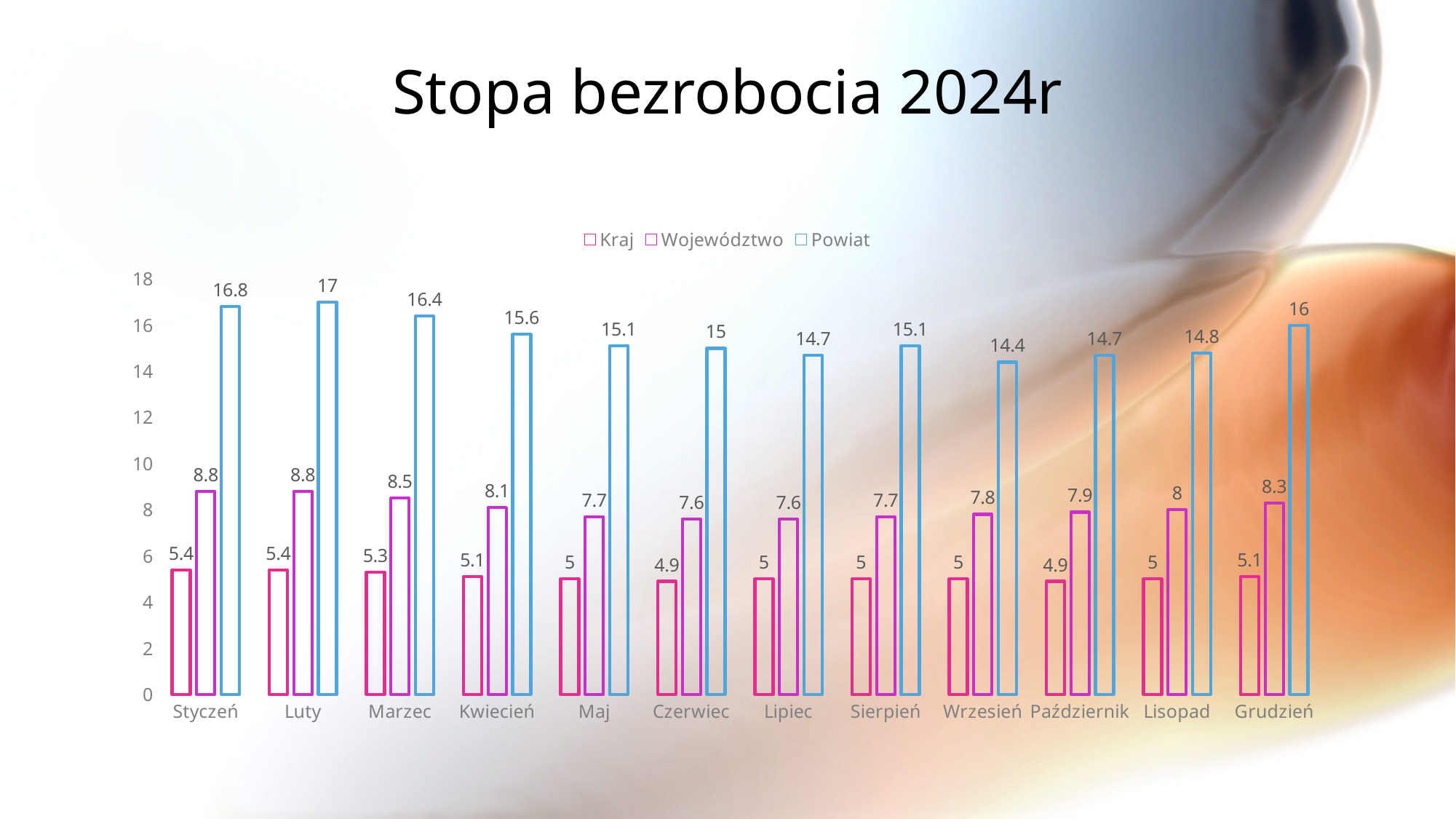
How many series does the legend list? 3 In which month is the Powiat value highest? Luty What kind of chart is shown on the slide? bar chart In which month is the Powiat value lowest? Wrzesień What is the Powiat value for Luty? 17 Is the Powiat value for Grudzień greater or less than 14? greater Which is larger, the Województwo value for Kwiecień or for Lisopad? Kwiecień What is the difference between the Powiat and Kraj values for Styczeń? 11.4 What is the Województwo value for Grudzień? 8.3 What is the difference between the Powiat values for Luty and Wrzesień? 2.6 How many months are shown on the x axis? 12 What is the Kraj value for Marzec? 5.3